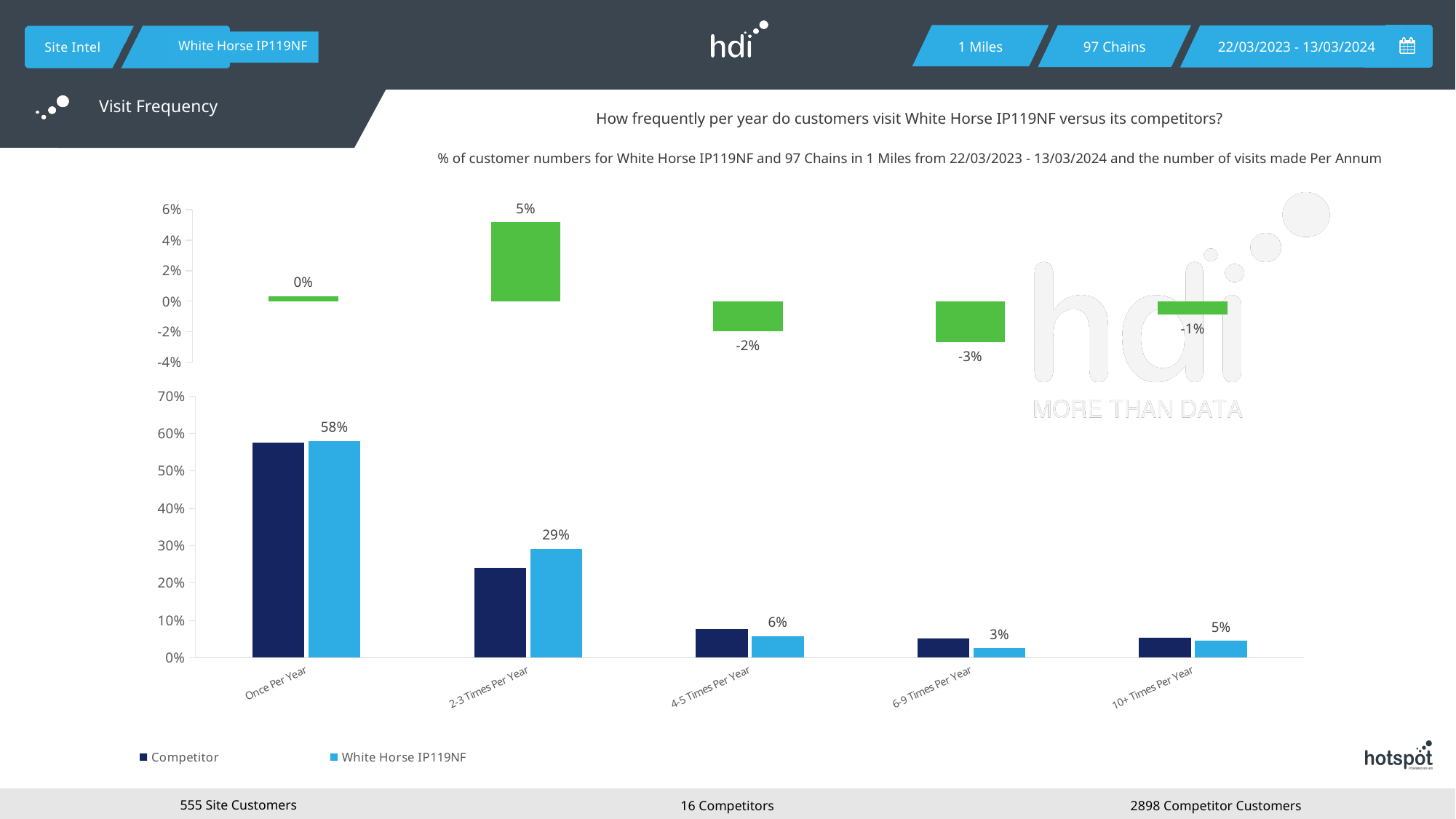
In the bottom chart, what is the value for White Horse IP119NF in the Once Per Year category? 58% In the top chart, what is the value shown for 6-9 Times Per Year? -3% In the bottom chart, is the Competitor value for 2-3 Times Per Year greater or less than 30%? less How many categories are shown on the x axis of the bottom chart? 5 In the top chart, which category has the lowest value? 6-9 Times Per Year In the top chart, what is the value shown for 2-3 Times Per Year? 5% How many series does the legend of the bottom chart list? 2 In the bottom chart, what is the difference between the White Horse IP119NF values for Once Per Year and 2-3 Times Per Year? 29% In the bottom chart, for 2-3 Times Per Year, which is larger: the Competitor bar or the White Horse IP119NF bar? White Horse IP119NF In the top chart, which category has the highest value? 2-3 Times Per Year In the bottom chart, what is the value for White Horse IP119NF in the 2-3 Times Per Year category? 29% In the bottom chart, is the Competitor value for Once Per Year greater or less than 50%? greater